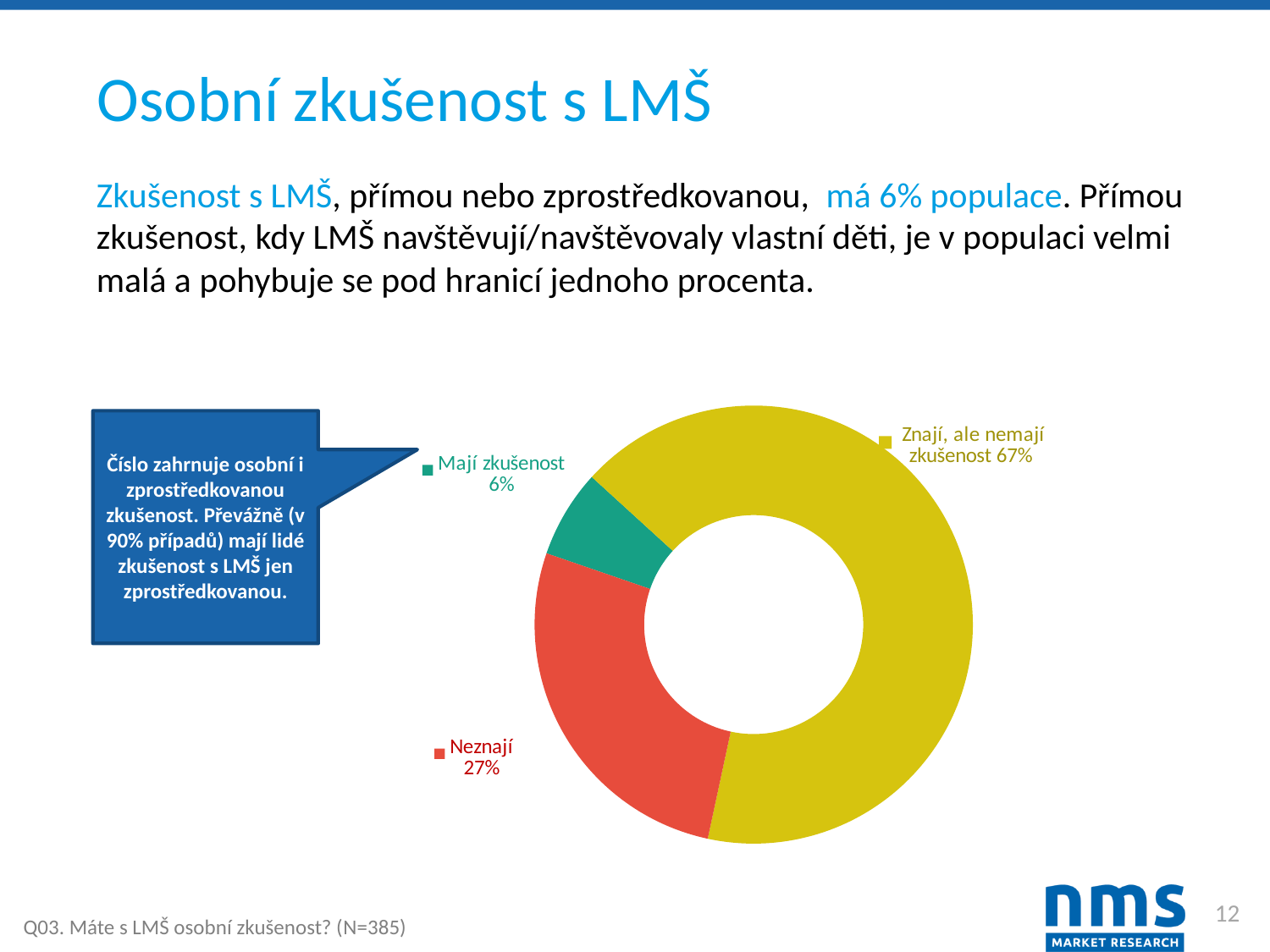
Which category has the largest share in the pie chart? Znají, ale nemají zkušenost What is the combined share of "Neznají" and "Mají zkušenost" in the pie chart? 33% What share of the pie chart is labelled "Neznají"? 27% Which category has the smallest share in the pie chart? Mají zkušenost What share of the pie chart is labelled "Mají zkušenost"? 6% How many categories are shown in the pie chart? 3 What colour is the "Mají zkušenost" slice in the pie chart? Green What colour is the "Neznají" slice in the pie chart? Red Which is larger: the share for "Neznají" or the share for "Mají zkušenost"? Neznají What share of the pie chart is labelled "Znají, ale nemají zkušenost"? 67% What is the difference in percentage points between "Znají, ale nemají zkušenost" and "Neznají"? 40 percentage points What kind of chart is shown on the slide? Pie chart (doughnut)